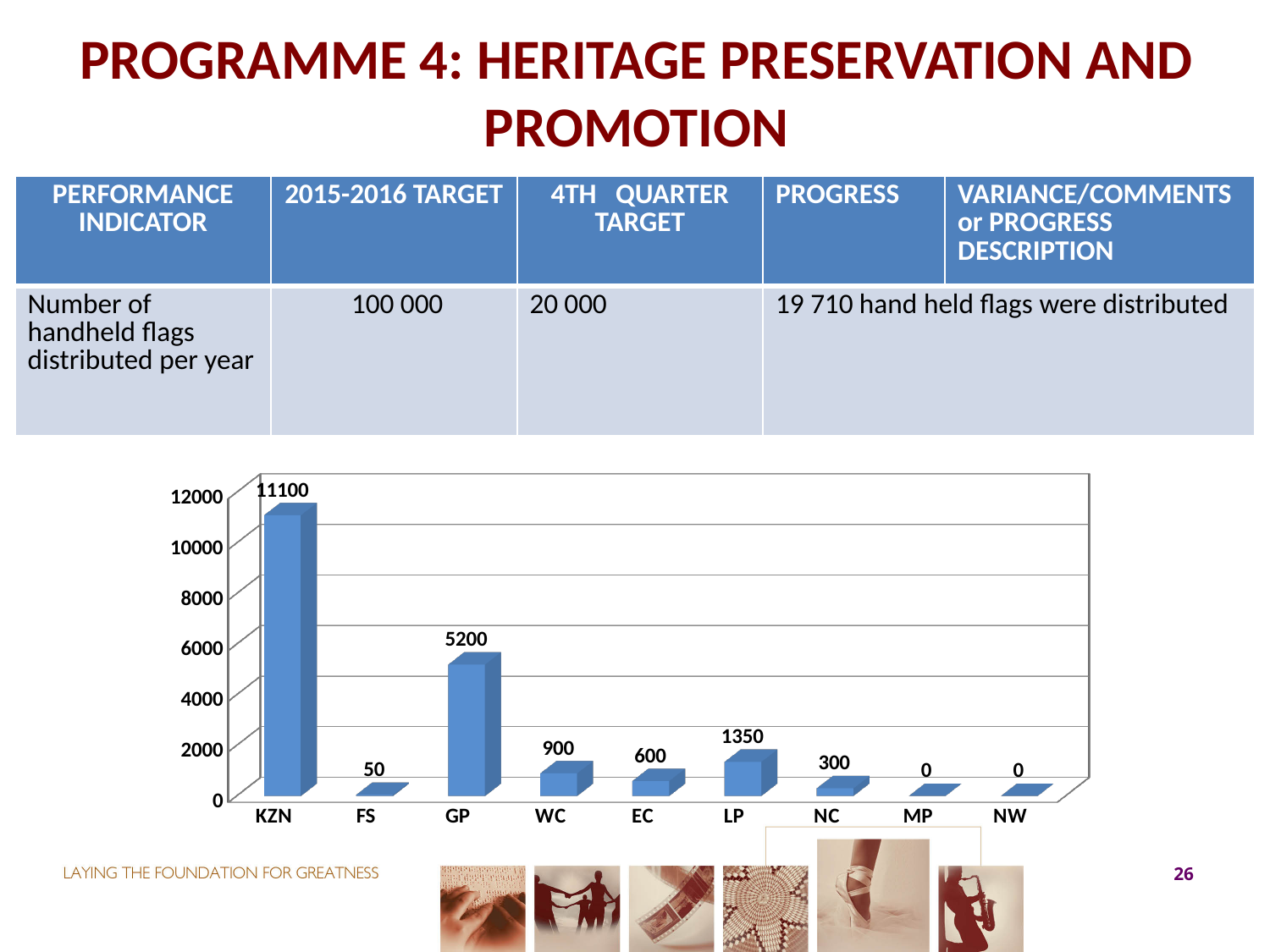
What is the value for LP? 1350 Which category has the highest value? KZN What is the value for KZN? 11100 Is the value for GP greater or less than 4000? greater What is the difference between the values for KZN and GP? 5900 How many categories are shown on the x axis? 9 Which categories have a value of 0? MP and NW What is the value for FS? 50 What is the value for GP? 5200 What is the difference between the values for LP and NC? 1050 Which is larger, the value for WC or the value for EC? WC What kind of chart is shown on the slide? bar chart